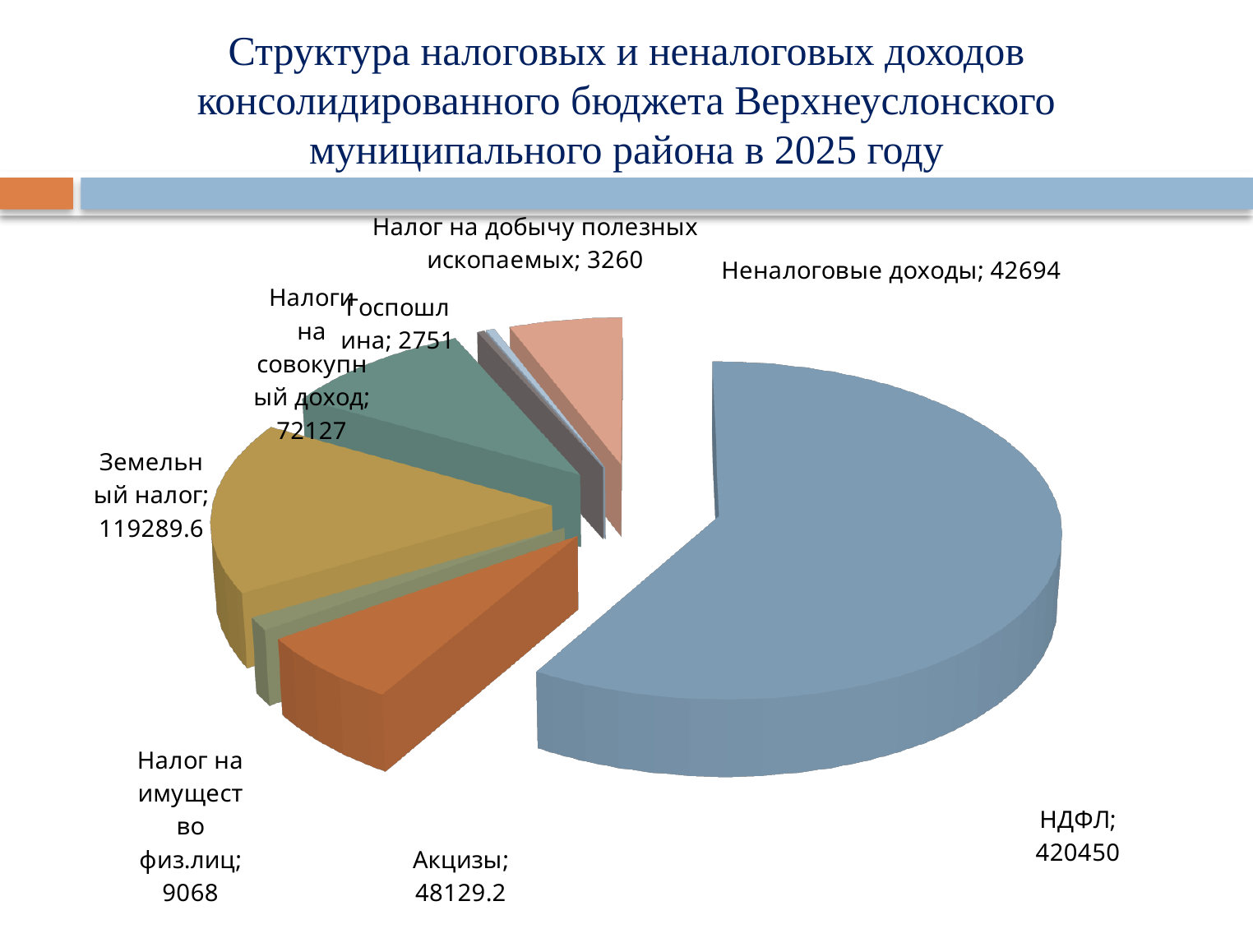
How many slices (categories) does the pie chart have? 8 What is the difference between Земельный налог and Налоги на совокупный доход? 47162.6 Which category has the smallest value? Госпошлина What is the difference between Налог на добычу полезных ископаемых and Госпошлина? 509 What is the value for Акцизы? 48129.2 What is the value for Госпошлина? 2751 What year does the chart title refer to? 2025 What is the value for НДФЛ? 420450 Which is larger: Акцизы or Неналоговые доходы? Акцизы Which category has the largest value? НДФЛ What type of chart is shown on the slide? Pie chart What is the value for Земельный налог? 119289.6